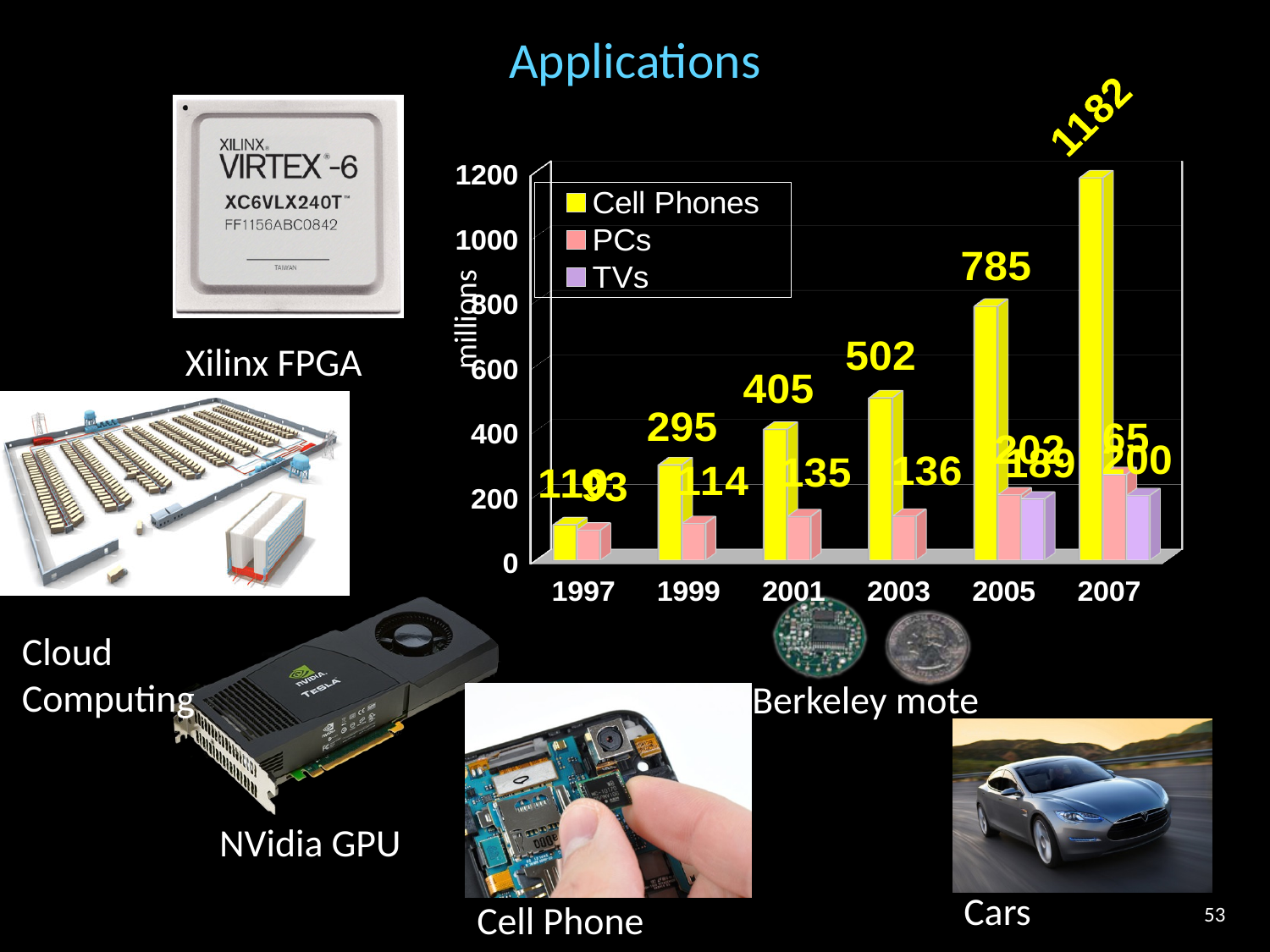
What is the difference between the Cell Phones values for 2003 and 2001? 97 In which year is the Cell Phones value highest? 2007 What is the value for Cell Phones in 2005? 785 Do the Cell Phones values rise or fall from 1997 to 2007? rise What is the value for Cell Phones in 2007? 1182 What is the difference between the Cell Phones values for 2007 and 2005? 397 Is the value for TVs in 2007 greater or less than 400? less What is the value for TVs in 2005? 189 How many years are shown on the x axis? 6 In 2003, which is larger: Cell Phones or PCs? Cell Phones What is the value for PCs in 2001? 135 How many series does the legend list? 3